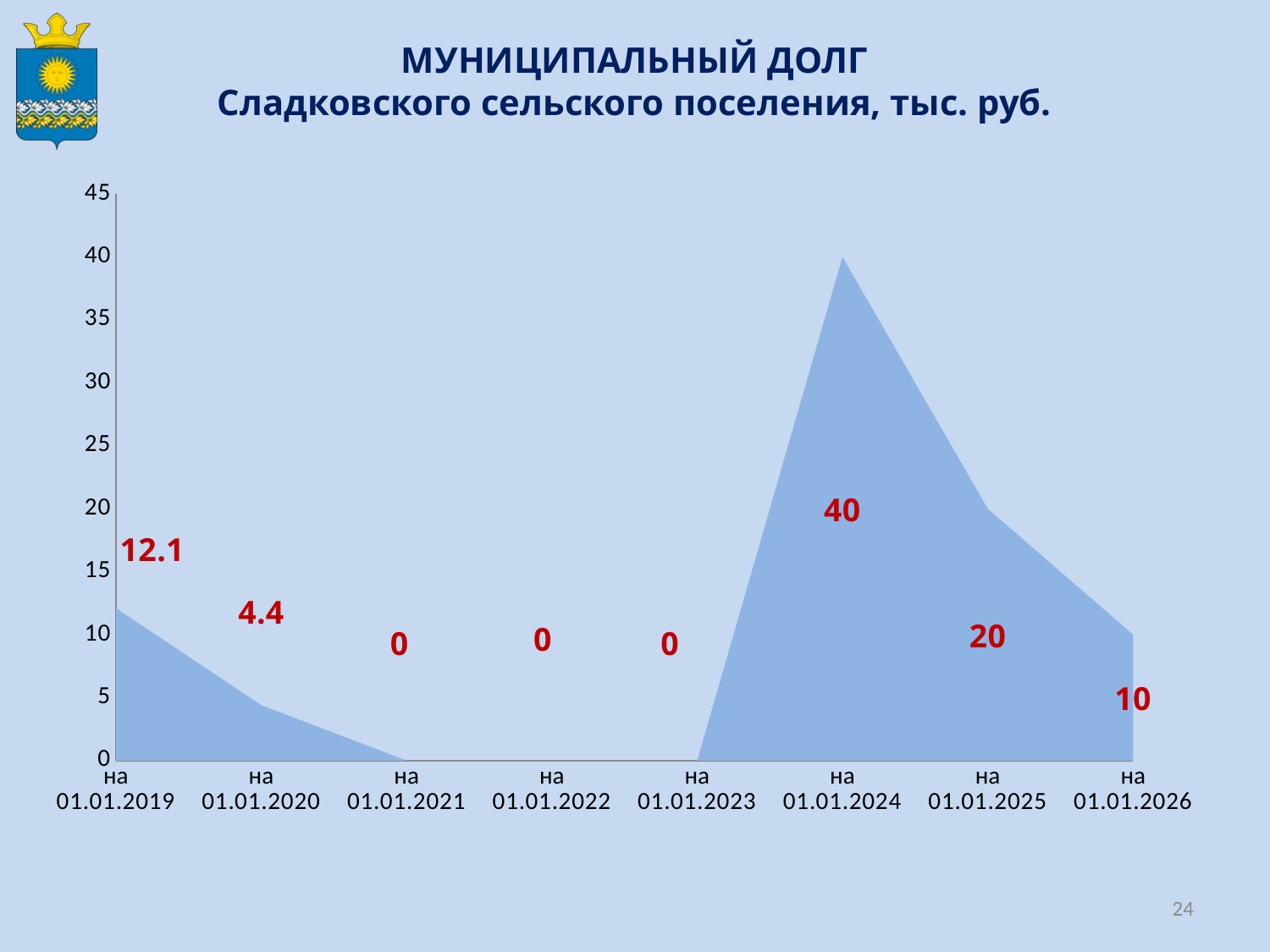
What is the municipal debt value on 01.01.2020? 4.4 What is the municipal debt value on 01.01.2024? 40 What kind of chart is shown on the slide? area chart What is the municipal debt value on 01.01.2019? 12.1 On which date is the municipal debt highest? на 01.01.2024 How many dates are shown on the x axis? 8 How many dates show a debt value of 0? 3 Which is larger, the debt on 01.01.2019 or on 01.01.2026? 01.01.2019 Do the values rise or fall from 01.01.2024 to 01.01.2026? fall What is the municipal debt value on 01.01.2025? 20 What is the difference between the debt on 01.01.2024 and on 01.01.2025? 20 What is the difference between the debt on 01.01.2019 and on 01.01.2020? 7.7